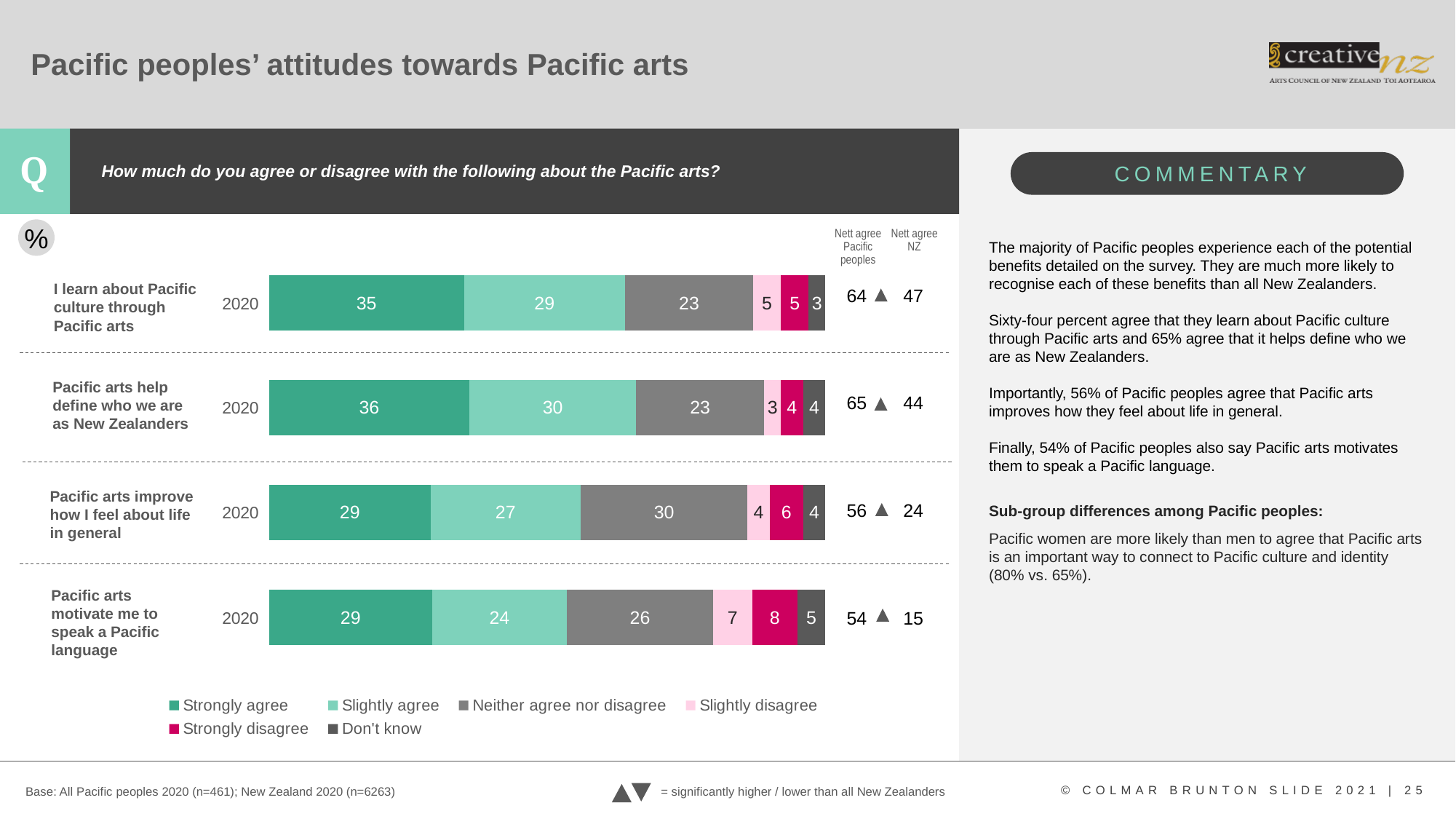
What is the 'Strongly disagree' value for 'Pacific arts motivate me to speak a Pacific language'? 8 Is the 'Neither agree nor disagree' value larger for 'Pacific arts improve how I feel about life in general' or for 'I learn about Pacific culture through Pacific arts'? Pacific arts improve how I feel about life in general How many series does the legend list? 6 What kind of chart is shown on the slide? Stacked bar chart What is the Nett agree value for Pacific peoples for 'Pacific arts improve how I feel about life in general'? 56 Which statement has the lowest 'Slightly agree' percentage? Pacific arts motivate me to speak a Pacific language What is the difference between the 'Strongly agree' and 'Slightly agree' values for 'Pacific arts motivate me to speak a Pacific language'? 5 What percentage of Pacific peoples strongly agree that they learn about Pacific culture through Pacific arts? 35 What is the 'Neither agree nor disagree' value for 'Pacific arts improve how I feel about life in general'? 30 Which statement has the highest 'Strongly agree' percentage? Pacific arts help define who we are as New Zealanders How many statements are shown in the chart? 4 What percentage of Pacific peoples slightly agree that Pacific arts help define who we are as New Zealanders? 30